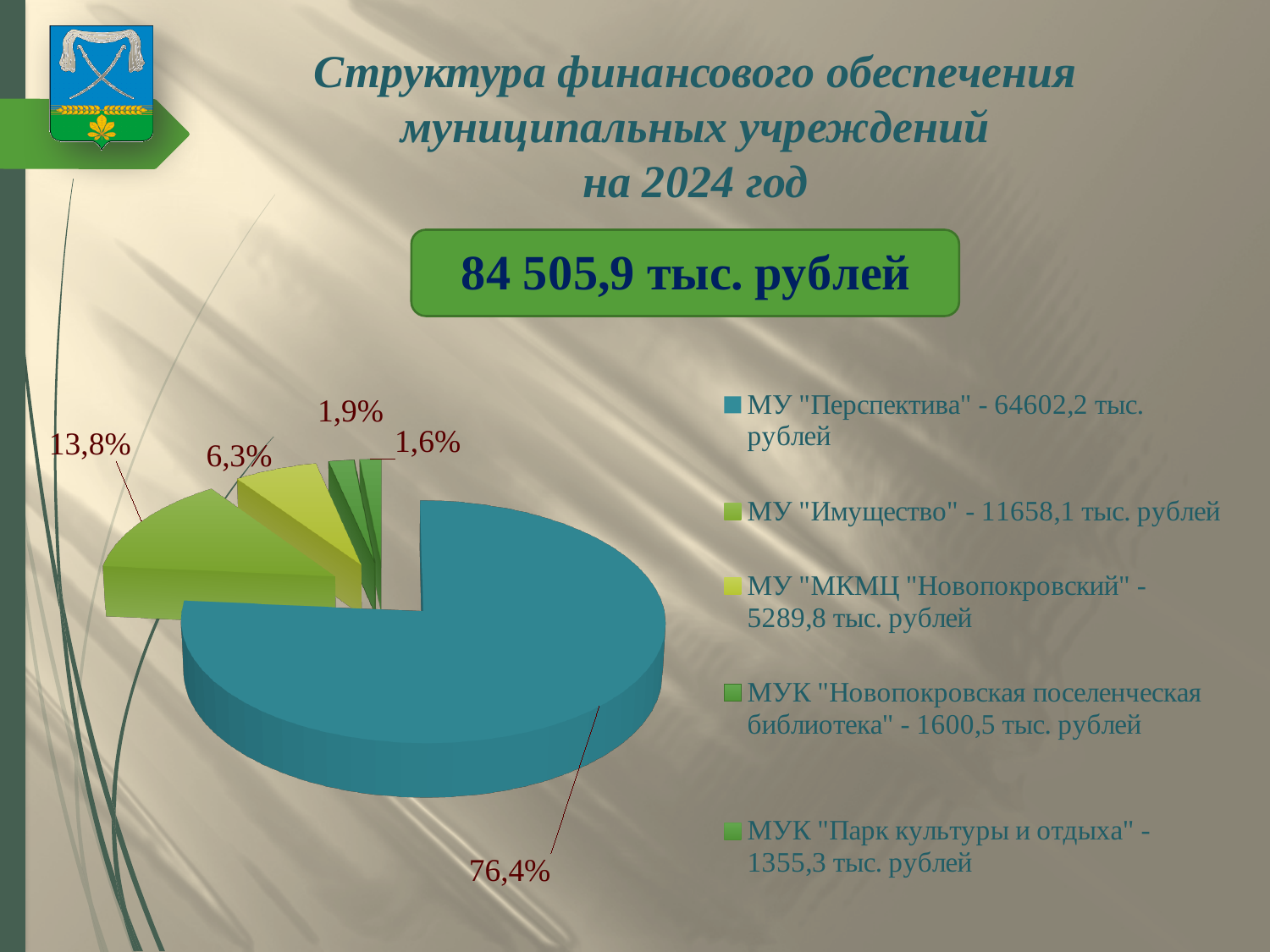
Which institution has the largest slice of the pie? МУ "Перспектива" What amount is listed in the legend for МУК "Новопокровская поселенческая библиотека"? 1600,5 тыс. рублей What share of the pie does МУ "МКМЦ "Новопокровский" account for? 6,3% What share of the pie does МУ "Имущество" account for? 13,8% What is the difference in percentage points between the shares of МУ "Перспектива" and МУ "Имущество"? 62,6 Which institution has the smallest slice of the pie? МУК "Парк культуры и отдыха" How many entries does the legend of the pie chart list? 5 What kind of chart is shown on the slide? pie chart What total amount is shown in the green box above the chart? 84 505,9 тыс. рублей What amount is listed in the legend for МУК "Парк культуры и отдыха"? 1355,3 тыс. рублей What share of the pie does МУ "Перспектива" account for? 76,4% How many slices does the pie chart have? 5